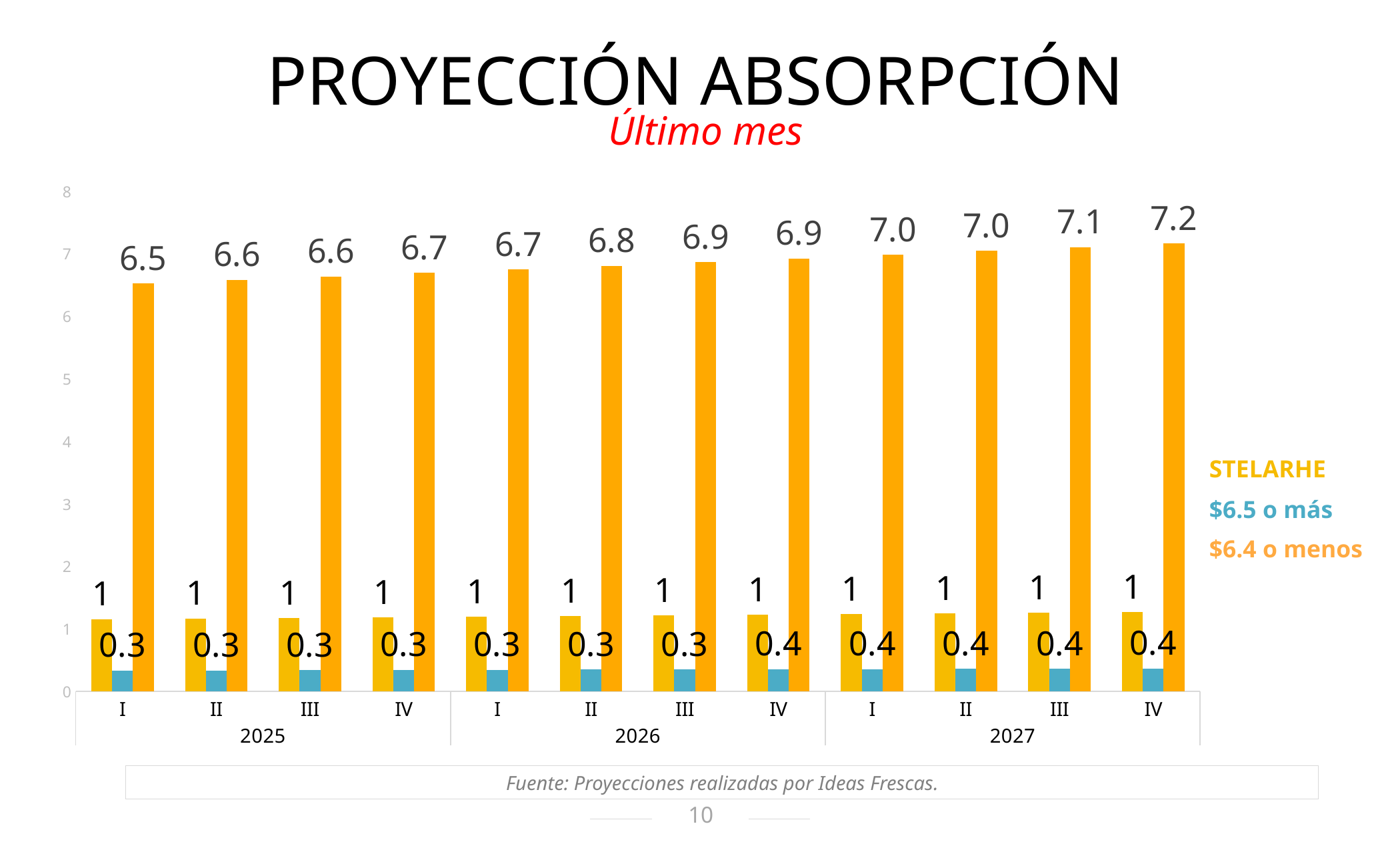
What is the value of the "$6.4 o menos" series for quarter IV of 2027? 7.2 How many series does the legend list? 3 What is the value of the "$6.4 o menos" series for quarter I of 2025? 6.5 Does the "$6.4 o menos" series rise or fall from 2025 to 2027? Rise What kind of chart is shown on the slide? Bar chart What is the value of the "$6.5 o más" series for quarter II of 2026? 0.3 Which is larger for quarter II of 2026: the "$6.4 o menos" value or the STELARHE value? $6.4 o menos What is the difference between the "$6.4 o menos" values for quarter IV of 2027 and quarter I of 2025? 0.7 What is the value of the "$6.5 o más" series for quarter III of 2027? 0.4 In which quarter does the "$6.4 o menos" series reach its highest value? IV 2027 What is the value of the STELARHE series for quarter I of 2027? 1 How many quarters are shown on the x axis? 12